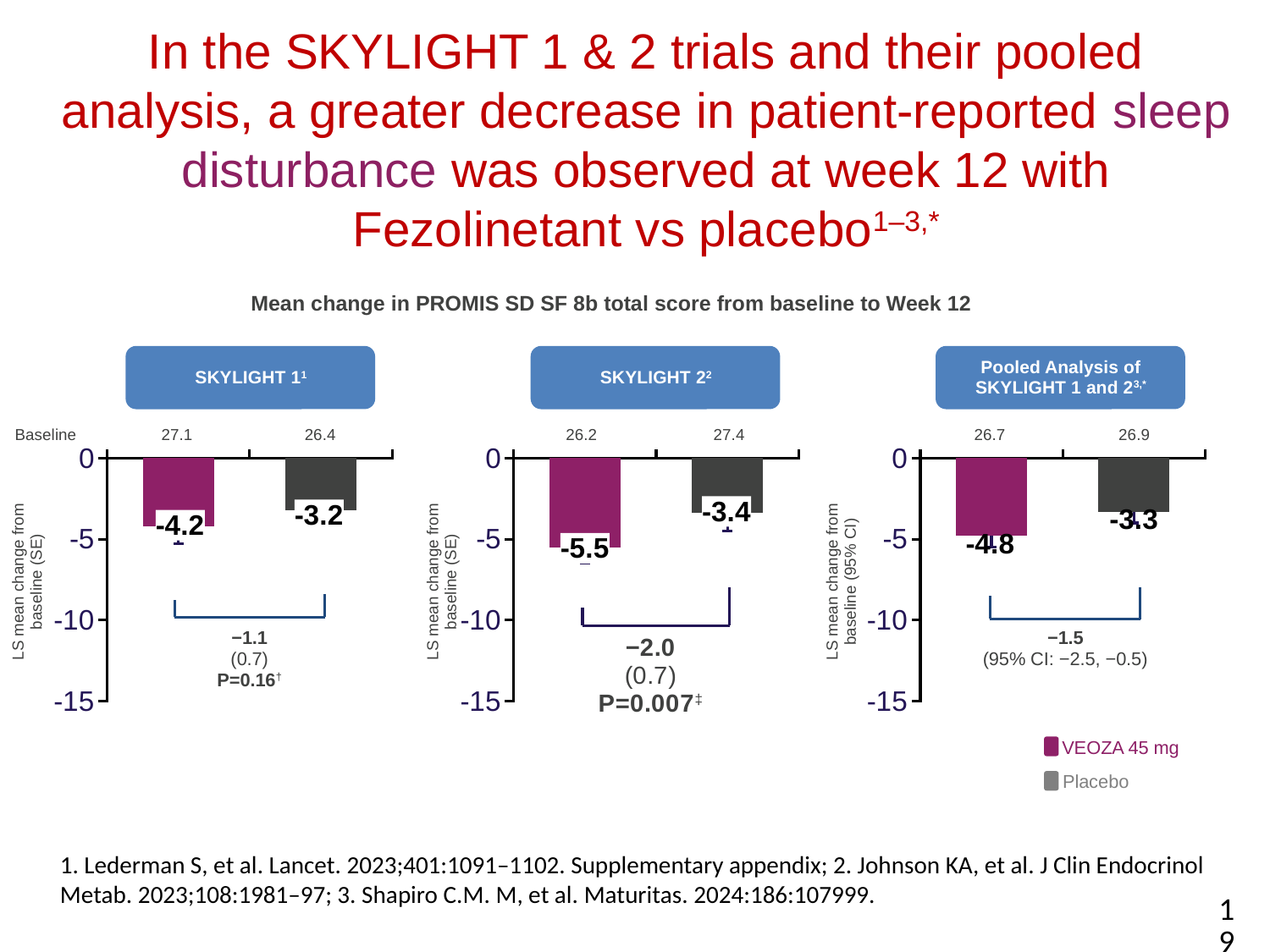
What type of chart is used in the SKYLIGHT 1 panel? Bar chart In the SKYLIGHT 2 chart, what is the baseline value shown for the VEOZA 45 mg group? 26.2 In the SKYLIGHT 1 chart, what P value is shown for the treatment difference? P=0.16 In the Pooled Analysis of SKYLIGHT 1 and 2 chart, what is the LS mean change from baseline for Placebo? -3.3 How many series does the legend list for the charts on this slide? 2 In the SKYLIGHT 1 chart, what is the LS mean change from baseline for VEOZA 45 mg? -4.2 In the SKYLIGHT 2 chart, what is the LS mean change from baseline for VEOZA 45 mg? -5.5 In the Pooled Analysis of SKYLIGHT 1 and 2 chart, what is the LS mean change from baseline for VEOZA 45 mg? -4.8 In the SKYLIGHT 1 chart, what is the LS mean change from baseline for Placebo? -3.2 In the SKYLIGHT 2 chart, what is the LS mean change from baseline for Placebo? -3.4 In the SKYLIGHT 2 chart, what is the difference between the VEOZA 45 mg and Placebo LS mean changes from baseline? −2.0 In the SKYLIGHT 2 chart, which group shows the larger decrease from baseline, VEOZA 45 mg or Placebo? VEOZA 45 mg